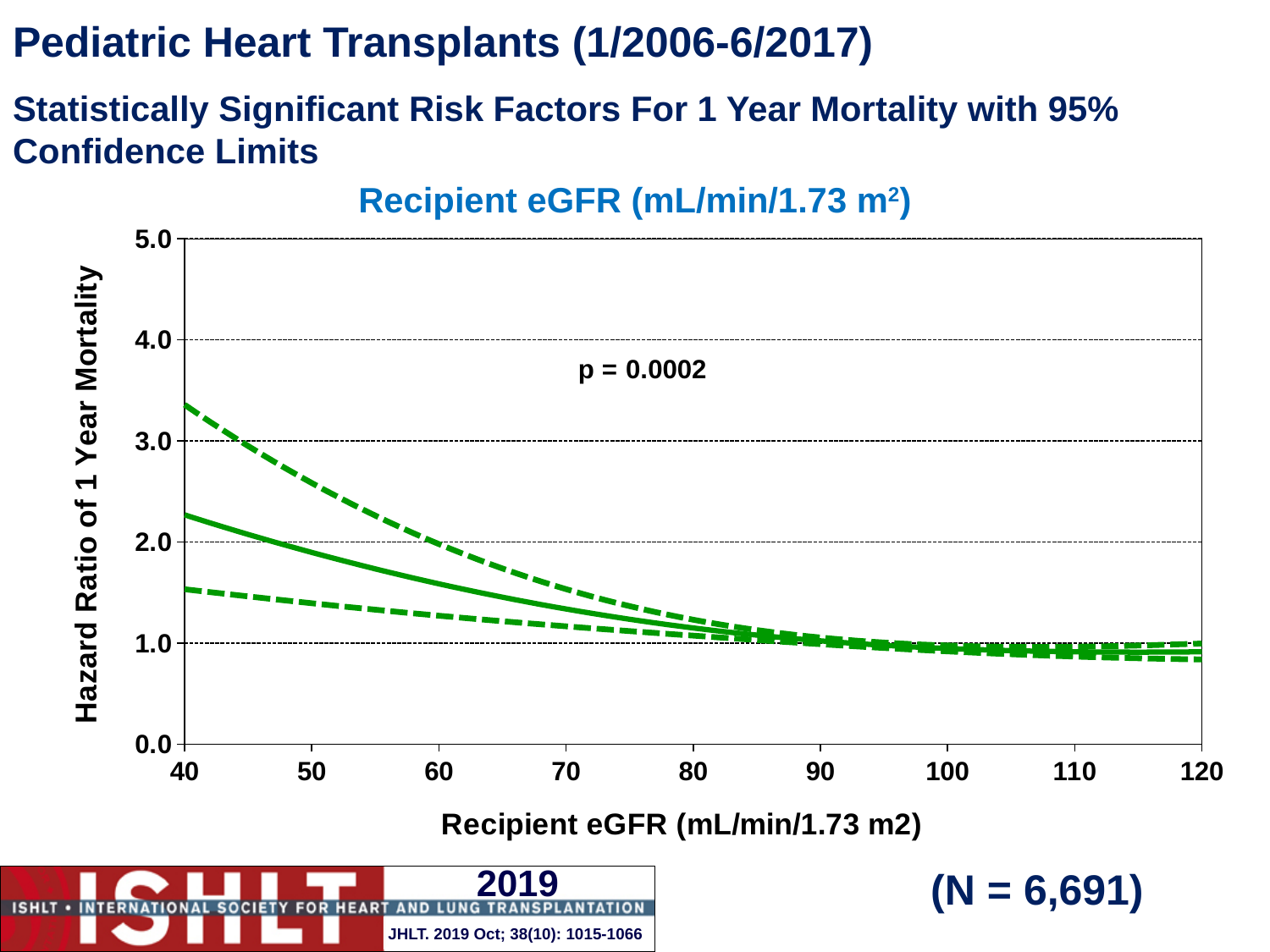
What kind of chart is shown on the slide? line chart Is the lower dashed confidence limit at a recipient eGFR of 40 greater or less than 2.0? less Is the upper dashed confidence limit at a recipient eGFR of 40 greater or less than 3.0? greater How many lines are plotted on the chart? 3 Is the hazard ratio on the solid line at a recipient eGFR of 100 greater or less than 2.0? less At which recipient eGFR value shown on the x axis is the solid hazard ratio line highest? 40 What sample size (N) is shown on the slide? N = 6,691 Does the solid hazard ratio line rise or fall as recipient eGFR increases from 40 to 120? fall What p-value is printed on the chart? p = 0.0002